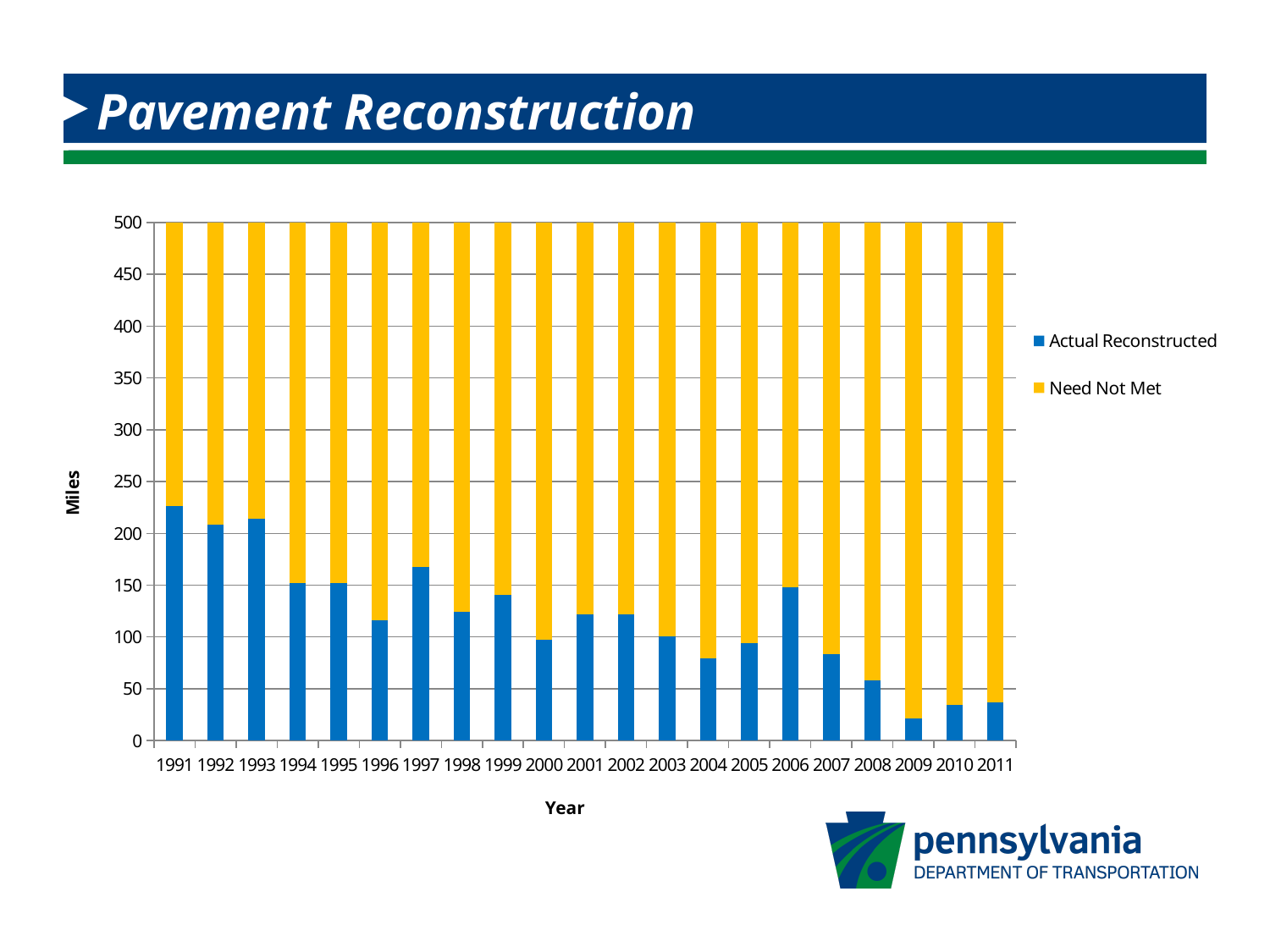
What kind of chart is shown on the slide? Stacked bar chart Which year has the highest value for Actual Reconstructed? 1991 Is the Actual Reconstructed value for 1991 greater or less than 200? greater Does the Actual Reconstructed value generally rise or fall from 1991 to 2011? Fall How many years are shown on the x axis? 21 What is the total height of the stacked bar for 2005 (Actual Reconstructed plus Need Not Met)? 500 Is the Actual Reconstructed value for 2004 greater or less than 100? less Is the Actual Reconstructed value for 2009 greater or less than 50? less Which year has the lowest value for Actual Reconstructed? 2009 How many series does the legend list? 2 Which year has a larger Actual Reconstructed value, 1997 or 1996? 1997